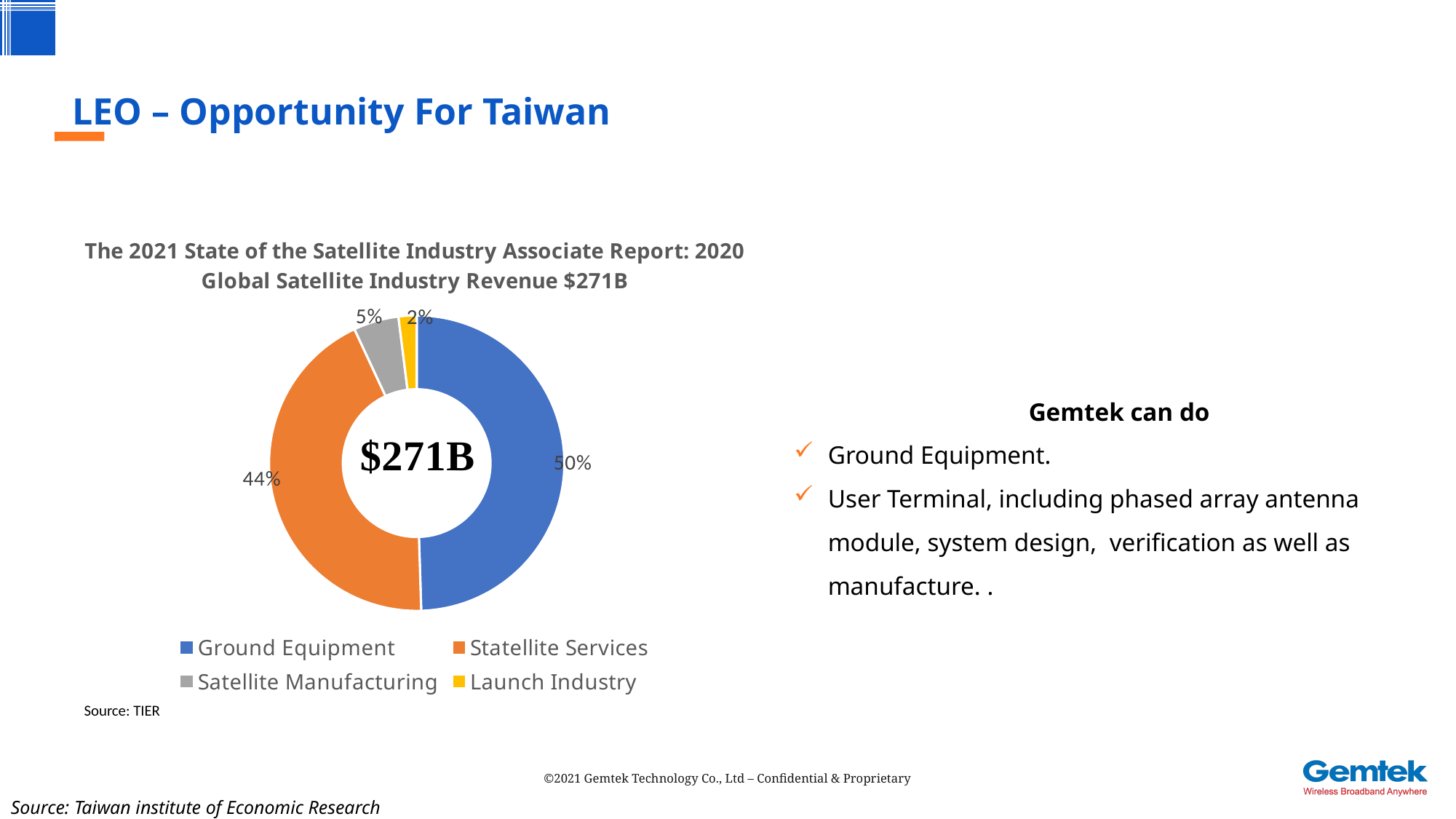
Which category has the smallest share in the chart? Launch Industry What share of the 2020 Global Satellite Industry Revenue does Ground Equipment account for? 50% How many categories does the chart show? 4 Which is larger, the share for Satellite Manufacturing or the share for Launch Industry? Satellite Manufacturing What is the difference in percentage points between Ground Equipment and Statellite Services? 6 Which colour represents Statellite Services in the chart legend? Orange What percentage is shown for Launch Industry? 2% What total revenue figure is printed in the centre of the chart? $271B What share does Satellite Manufacturing hold in the chart? 5% What kind of chart is shown on the slide? Doughnut (pie) chart What percentage of the chart is Statellite Services? 44% Which category has the largest share of the 2020 Global Satellite Industry Revenue? Ground Equipment